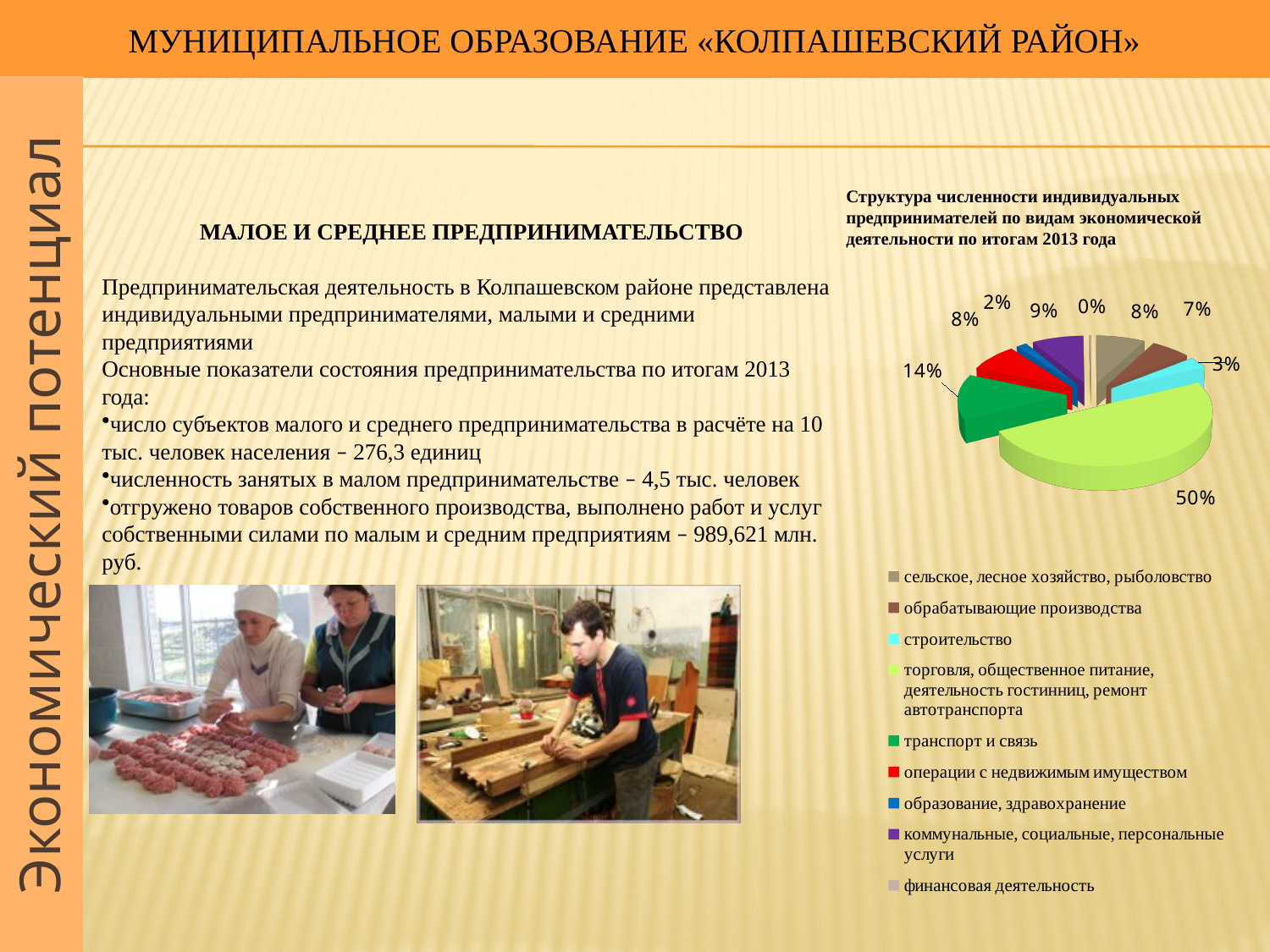
What share is shown for строительство? 3% What share is shown for финансовая деятельность? 0% How many categories does the chart legend list? 9 What share is shown for коммунальные, социальные, персональные услуги? 9% Which category has the smallest share of the pie? финансовая деятельность What is the title of the chart? Структура численности индивидуальных предпринимателей по видам экономической деятельности по итогам 2013 года What share is shown for транспорт и связь? 14% What is the difference between the share for торговля, общественное питание, деятельность гостинниц, ремонт автотранспорта and the share for транспорт и связь? 36% What is the share of the largest slice of the pie? 50% What kind of chart is shown on the slide? pie chart Which is larger: the share for транспорт и связь or the share for строительство? транспорт и связь Which category has the largest share of the pie? торговля, общественное питание, деятельность гостинниц, ремонт автотранспорта